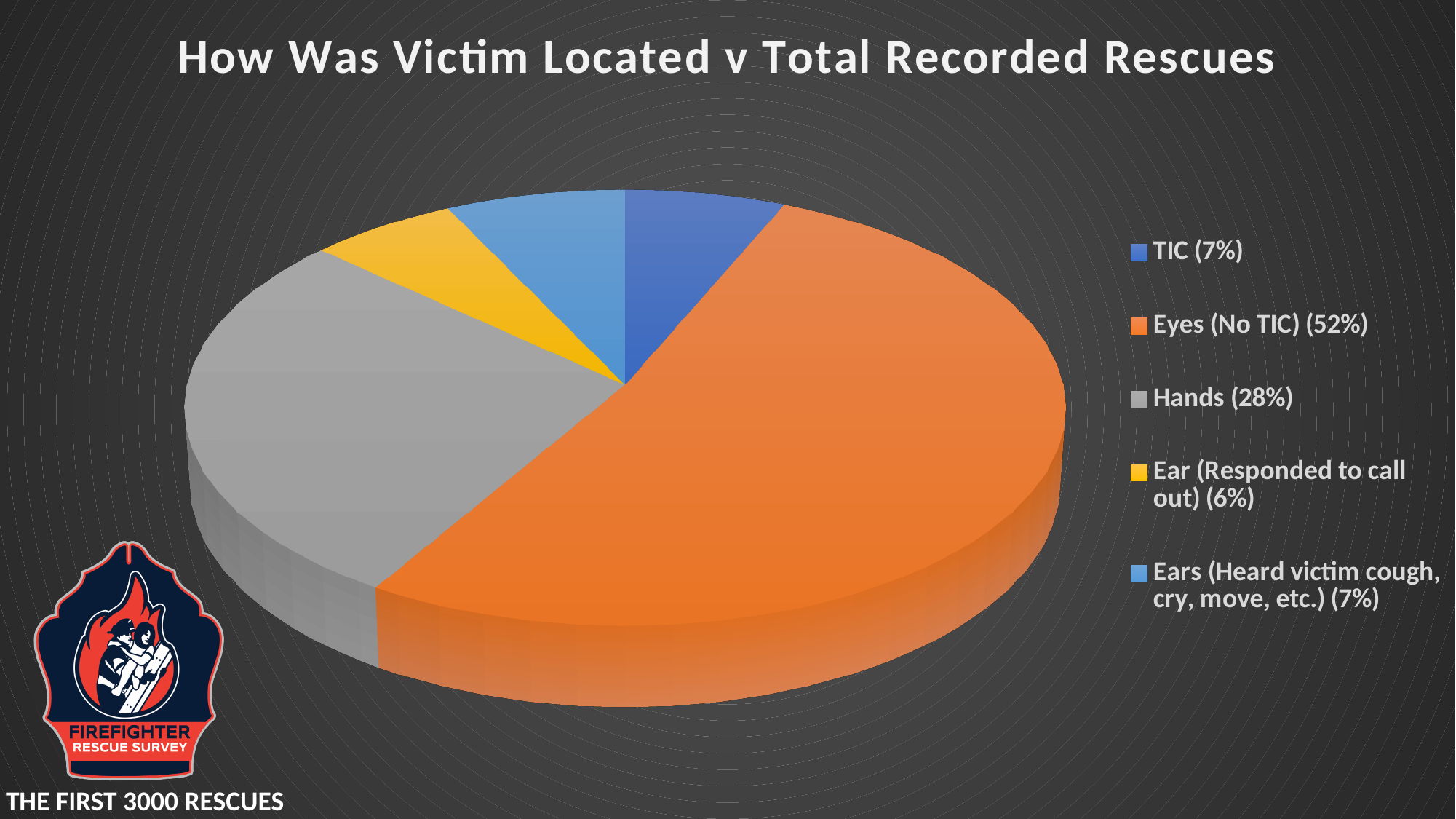
What is the difference in percentage points between Eyes (No TIC) and Hands? 24 Which category has the smallest share of the pie? Ear (Responded to call out) What share of rescues is attributed to Ear (Responded to call out)? 6% What share of rescues is attributed to Hands? 28% What kind of chart is shown on the slide? Pie chart Which category has the largest share of the pie? Eyes (No TIC) What share of rescues is attributed to Eyes (No TIC)? 52% Which colour represents Hands in the pie chart? Grey What is the title of the chart? How Was Victim Located v Total Recorded Rescues How many categories does the pie chart show? 5 Which is larger, the share for Hands or the share for TIC? Hands